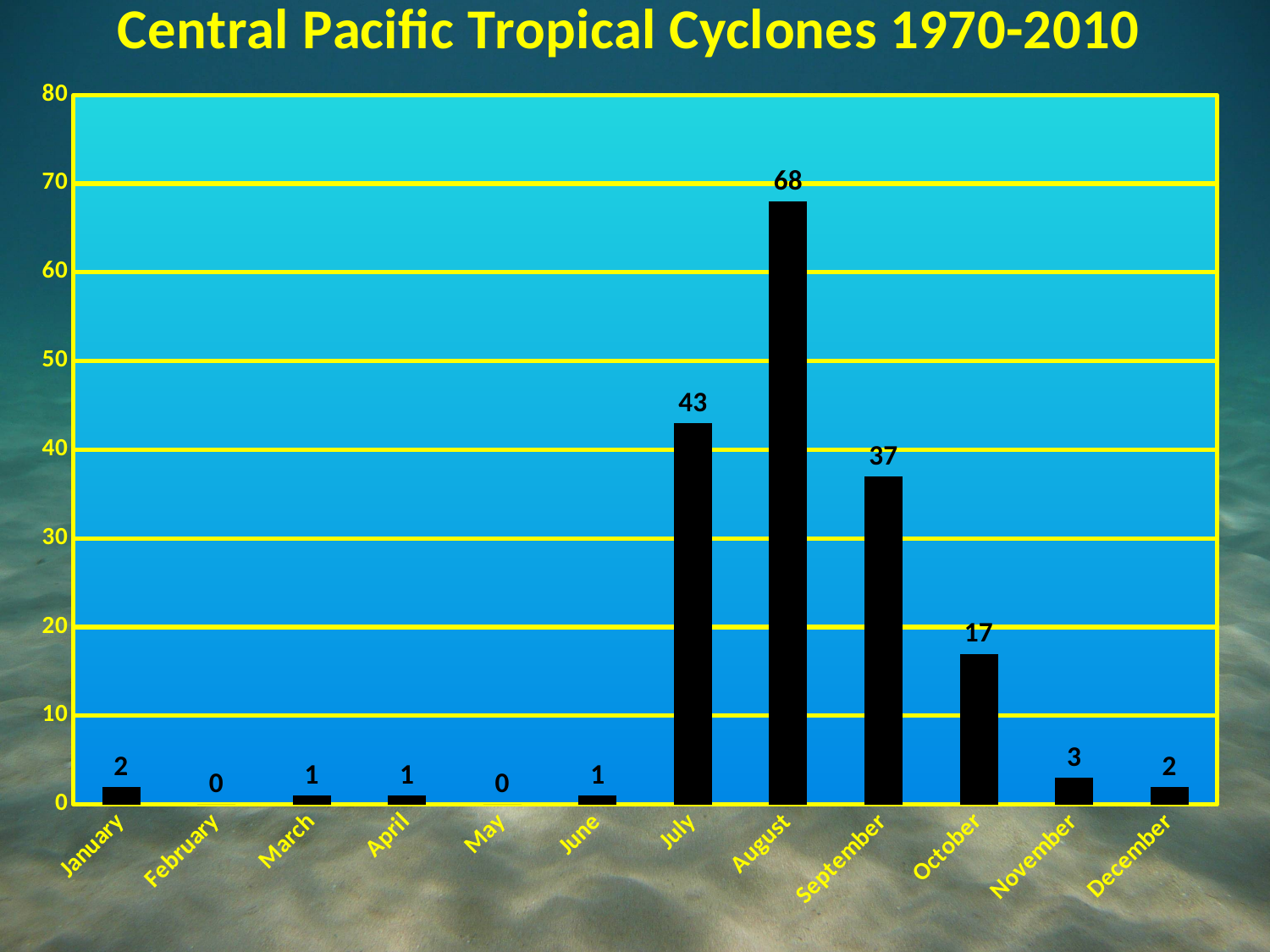
What is the difference between the values for August and July? 25 What kind of chart is shown on the slide? bar chart What is the value for August? 68 Which month has the highest value? August What is the difference between the values for September and October? 20 Which is larger, the value for July or the value for September? July What is the title of the chart? Central Pacific Tropical Cyclones 1970-2010 Is the value for August greater or less than 60? greater What is the value for October? 17 How many months are shown on the x axis? 12 Which months have a value of 0? February and May What is the value for November? 3